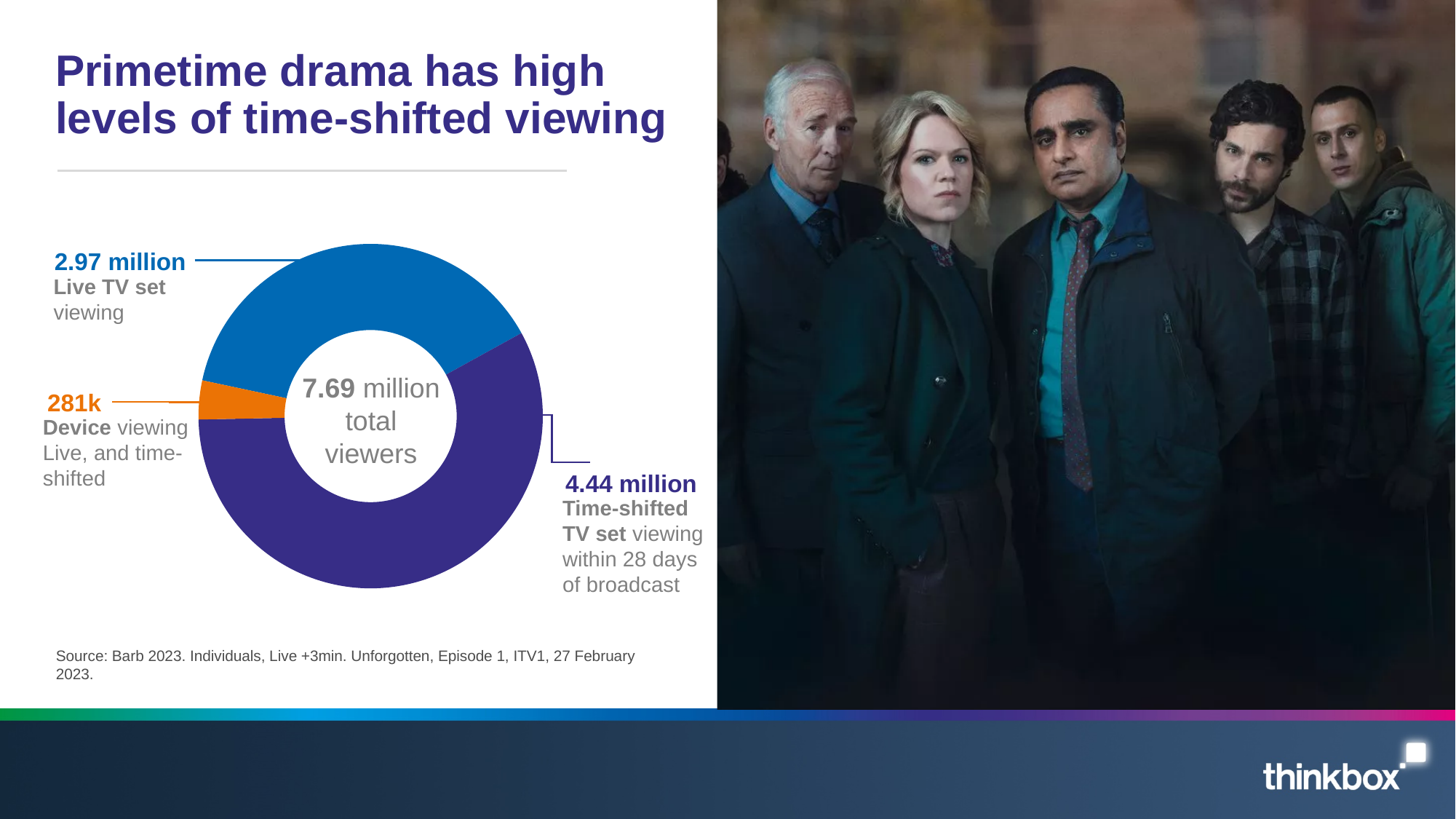
What colour is the Device viewing segment of the donut chart? Orange Which is larger, Live TV set viewing or Time-shifted TV set viewing? Time-shifted TV set viewing What is the value for Time-shifted TV set viewing within 28 days of broadcast? 4.44 million Which segment of the donut chart is the smallest? Device viewing What is the title of the slide containing the donut chart? Primetime drama has high levels of time-shifted viewing How many segments does the donut chart have? 3 What is the difference between Time-shifted TV set viewing and Live TV set viewing? 1.47 million What kind of chart is shown on the slide? Donut (pie) chart What is the total number of viewers shown in the centre of the donut chart? 7.69 million What is the value for Device viewing (live and time-shifted)? 281k What is the value for Live TV set viewing? 2.97 million Which segment of the donut chart is the largest? Time-shifted TV set viewing